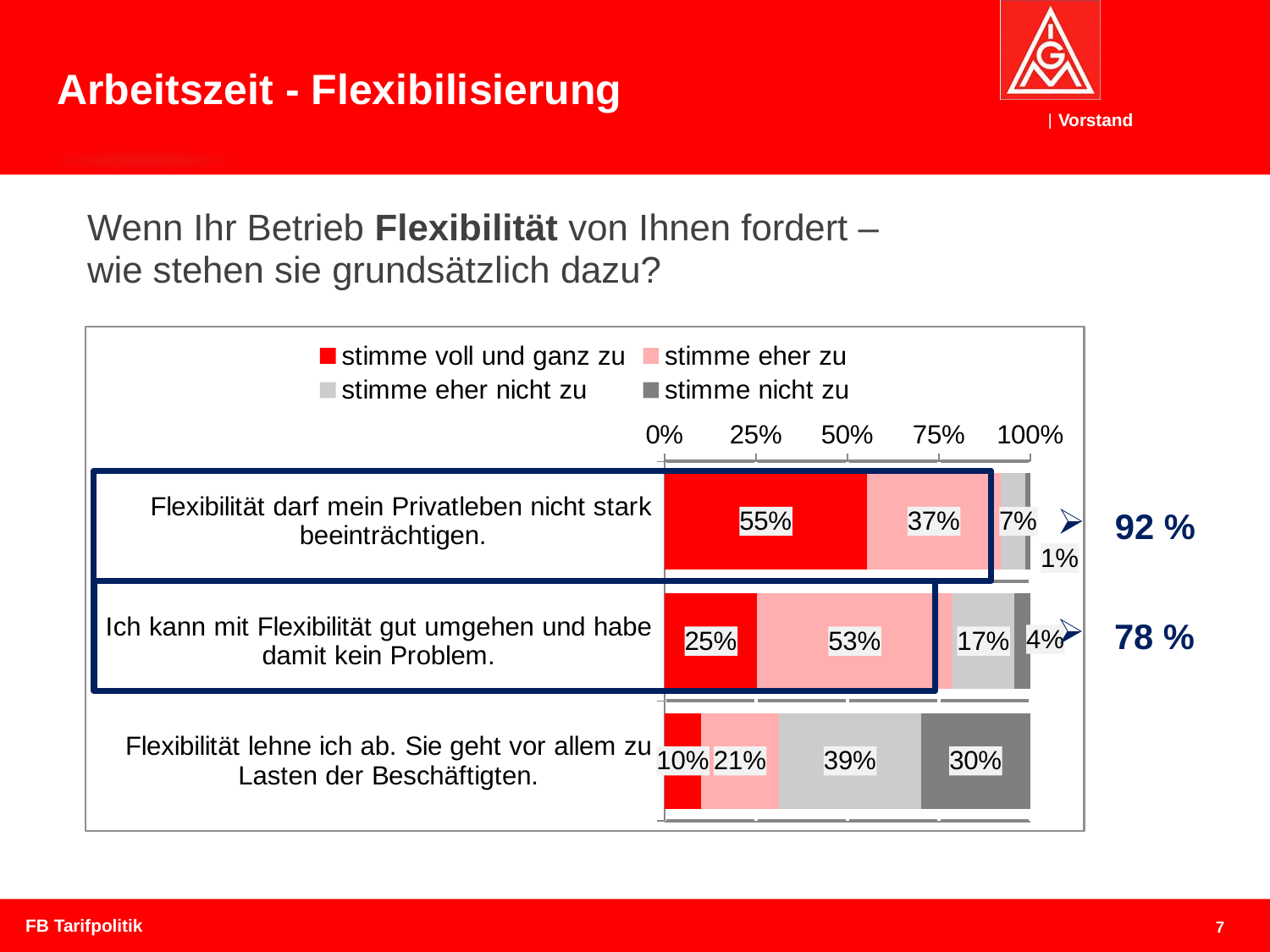
What is the difference between the "stimme eher nicht zu" value and the "stimme nicht zu" value for the statement "Flexibilität lehne ich ab. Sie geht vor allem zu Lasten der Beschäftigten."? 9% What is the value of "stimme nicht zu" for the statement "Flexibilität lehne ich ab. Sie geht vor allem zu Lasten der Beschäftigten."? 30% What colour represents the series "stimme voll und ganz zu" in the legend? red Which statement has the highest value for "stimme voll und ganz zu"? Flexibilität darf mein Privatleben nicht stark beeinträchtigen. How many statements (categories) are plotted in the chart? 3 What is the value of "stimme voll und ganz zu" for the statement "Flexibilität darf mein Privatleben nicht stark beeinträchtigen."? 55% What kind of chart is shown on the slide? stacked bar chart What is the value of "stimme eher nicht zu" for the statement "Ich kann mit Flexibilität gut umgehen und habe damit kein Problem."? 17% For the statement "Ich kann mit Flexibilität gut umgehen und habe damit kein Problem.", which is larger: "stimme voll und ganz zu" or "stimme eher zu"? stimme eher zu How many series does the legend list? 4 Which statement has the lowest value for "stimme nicht zu"? Flexibilität darf mein Privatleben nicht stark beeinträchtigen. What is the value of "stimme eher zu" for the statement "Ich kann mit Flexibilität gut umgehen und habe damit kein Problem."? 53%